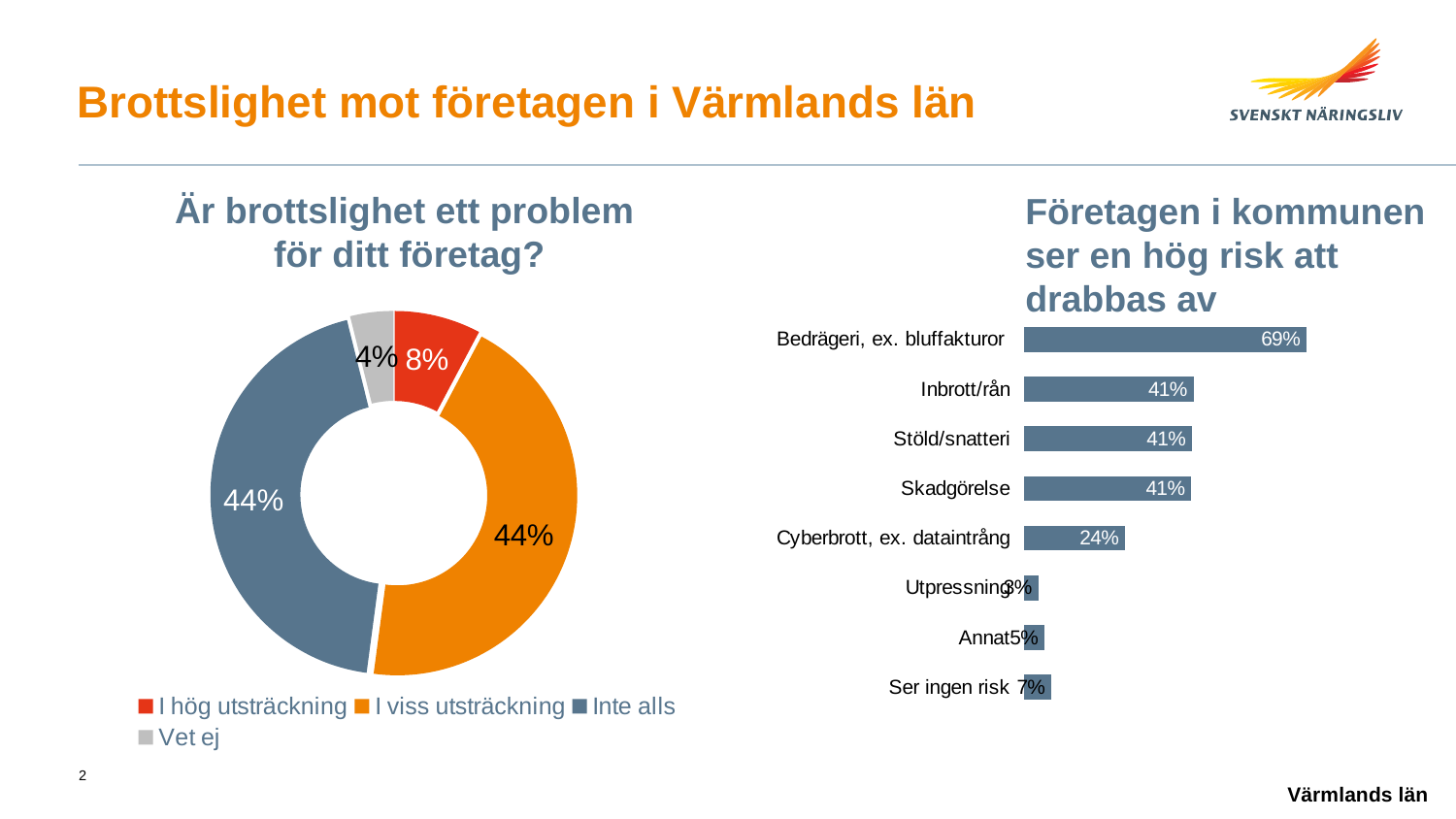
In the doughnut chart 'Är brottslighet ett problem för ditt företag?', what share of respondents answered 'I hög utsträckning'? 8% In the bar chart 'Företagen i kommunen ser en hög risk att drabbas av', which is larger: 'Skadgörelse' or 'Cyberbrott, ex. dataintrång'? Skadgörelse How many categories are shown in the bar chart 'Företagen i kommunen ser en hög risk att drabbas av'? 8 In the bar chart 'Företagen i kommunen ser en hög risk att drabbas av', what is the value for 'Cyberbrott, ex. dataintrång'? 24% In the bar chart 'Företagen i kommunen ser en hög risk att drabbas av', what is the difference between 'Bedrägeri, ex. bluffakturor' and 'Inbrott/rån'? 28 percentage points How many entries does the legend of the doughnut chart 'Är brottslighet ett problem för ditt företag?' list? 4 What kind of chart is the right chart 'Företagen i kommunen ser en hög risk att drabbas av'? Bar chart In the bar chart 'Företagen i kommunen ser en hög risk att drabbas av', which category has the highest value? Bedrägeri, ex. bluffakturor What kind of chart is the left chart 'Är brottslighet ett problem för ditt företag?'? Doughnut (pie) chart In the bar chart 'Företagen i kommunen ser en hög risk att drabbas av', what is the value for 'Bedrägeri, ex. bluffakturor'? 69% In the doughnut chart 'Är brottslighet ett problem för ditt företag?', what share of respondents answered 'Vet ej'? 4% In the doughnut chart 'Är brottslighet ett problem för ditt företag?', what share answered 'Inte alls'? 44%